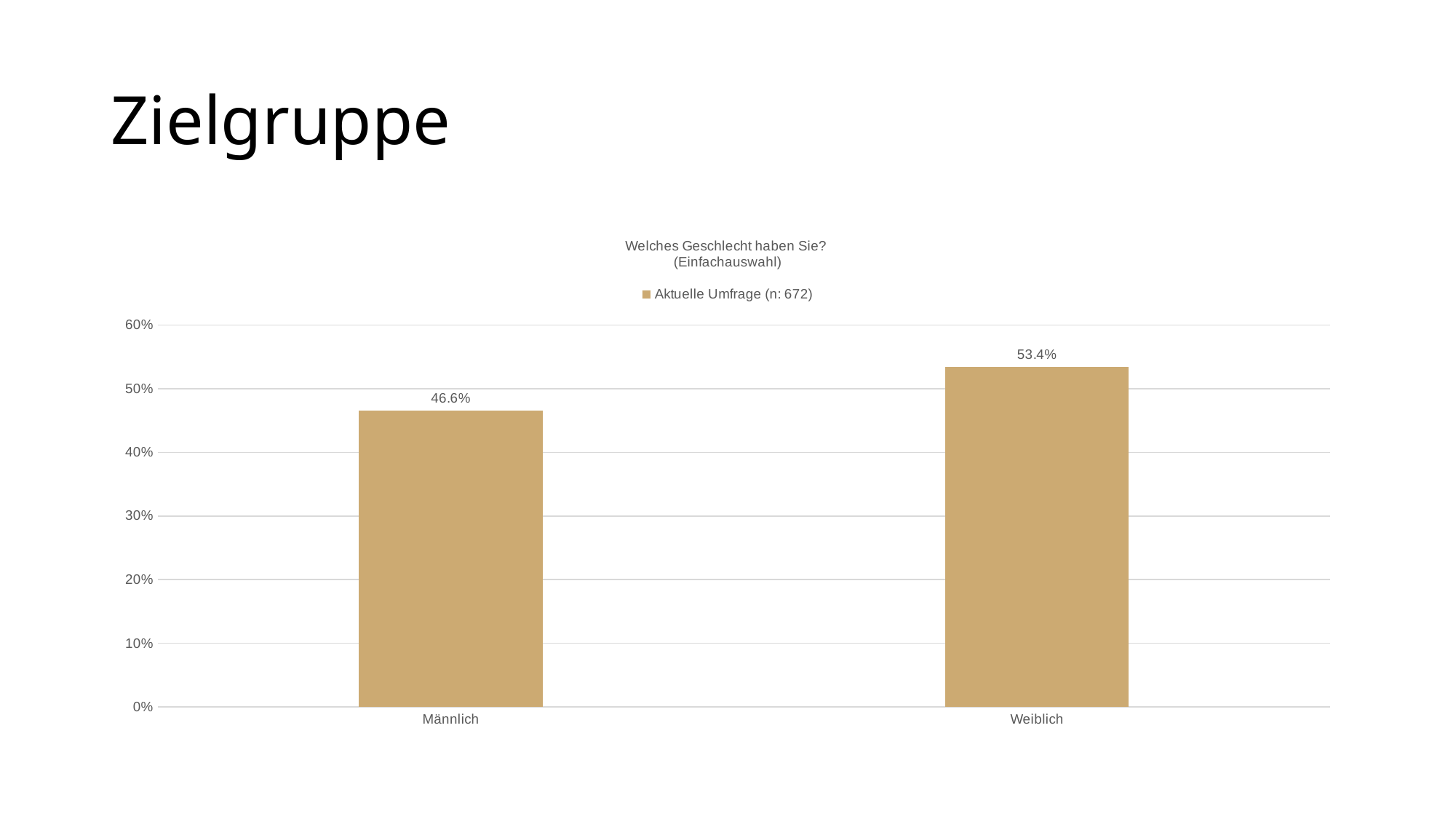
Which is larger, the value for Männlich or the value for Weiblich? Weiblich Which category has the highest value? Weiblich Is the value for Weiblich greater or less than 50%? greater Which category has the lowest value? Männlich How many series does the legend list? 1 What is the value for Männlich? 46.6% How many categories are shown on the x axis? 2 Is the value for Männlich greater or less than 50%? less What is the series name shown in the legend? Aktuelle Umfrage (n: 672) What kind of chart is shown? bar chart What is the difference between the values for Weiblich and Männlich? 6.8% What is the value for Weiblich? 53.4%